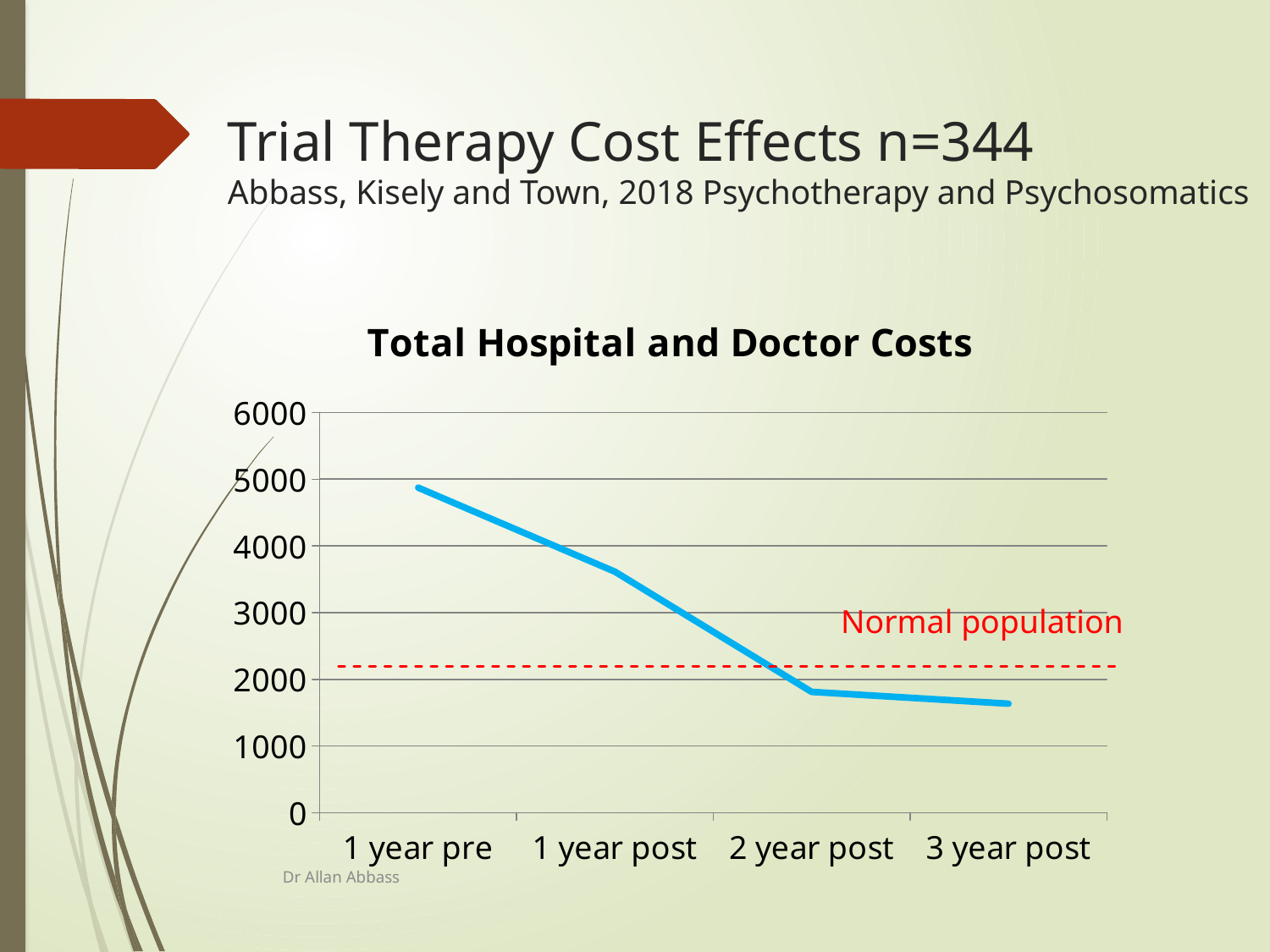
Is the value for 3 year post greater or less than 2000? less Do the costs rise or fall from 1 year pre to 3 year post? fall Is the value for 1 year post greater or less than 3000? greater Is the value for 1 year pre greater or less than 5000? less What is the title of the chart? Total Hospital and Doctor Costs What kind of chart is shown on the slide? line chart What does the red dashed horizontal line represent? Normal population How many time points are plotted along the x axis? 4 Which time point has the highest total hospital and doctor cost? 1 year pre Which is larger, the value for 1 year pre or the value for 2 year post? 1 year pre